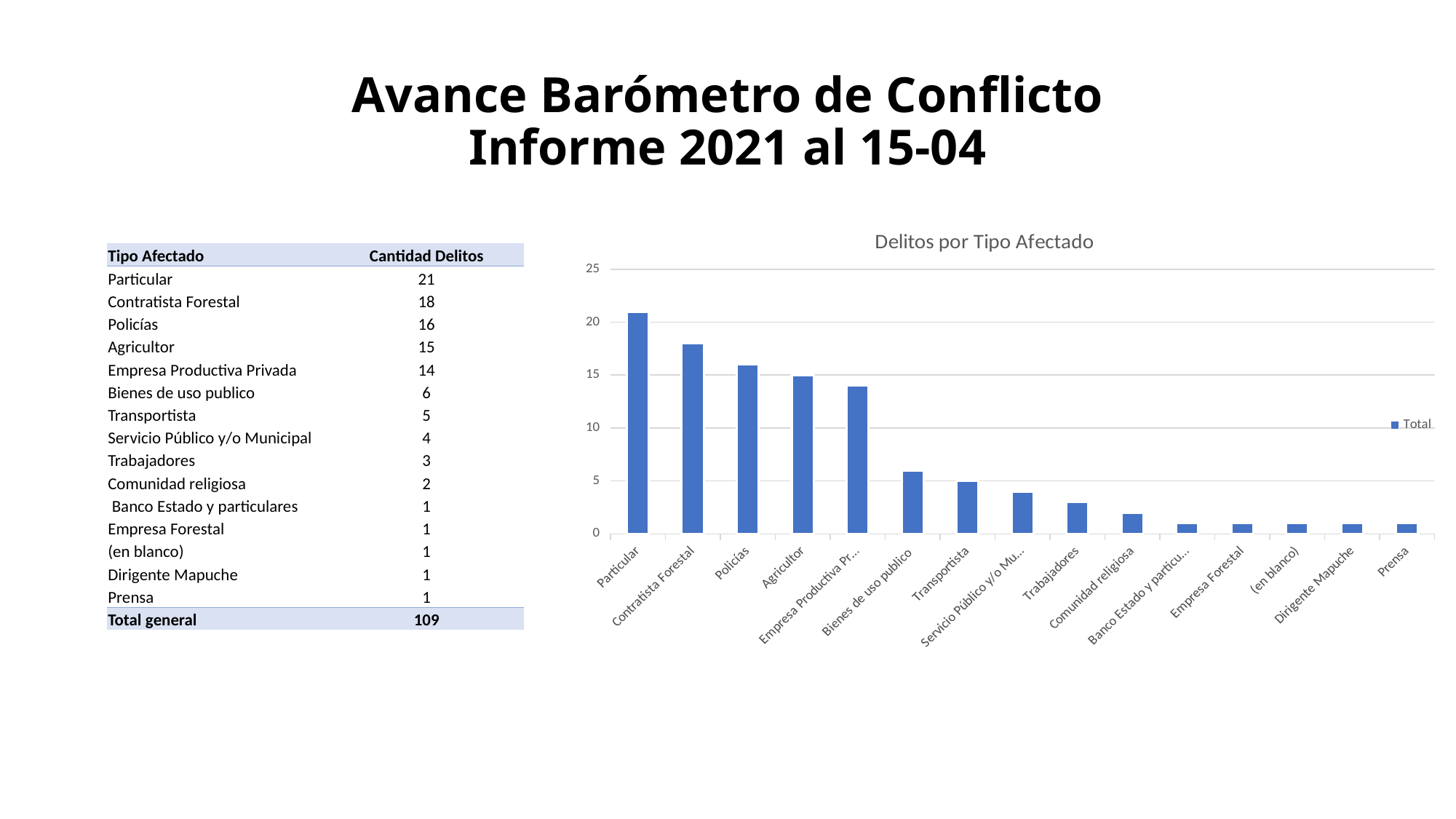
What is the total of all values shown (Total general)? 109 What is the value for Particular? 21 What is the title of the chart? Delitos por Tipo Afectado Which is larger, the value for Agricultor or the value for Bienes de uso publico? Agricultor Which category has the highest value in the chart? Particular What is the difference between the values for Contratista Forestal and Policías? 2 What is the value for Transportista? 5 What type of chart is shown on the slide? bar chart Do the values rise or fall from left to right along the x axis? fall How many series does the chart legend list? 1 Is the value for Contratista Forestal greater or less than 15? greater How many categories are plotted on the x axis of the chart? 15